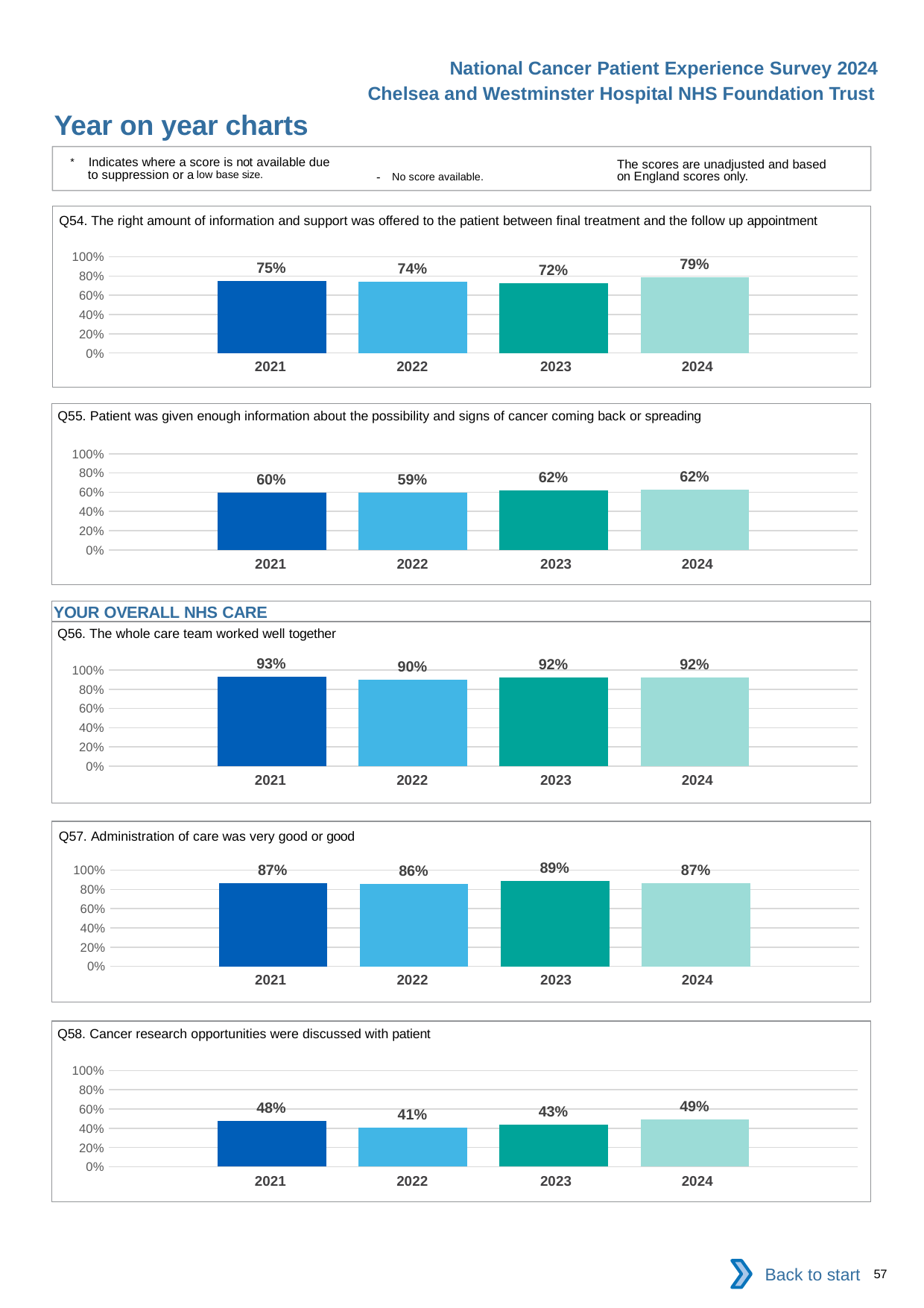
In the Q58 chart, which year has the highest value? 2024 In the Q54 chart, what is the value for 2024? 79% In the Q56 chart, what is the value for 2022? 90% In the Q57 chart, what is the difference between the 2023 value and the 2021 value? 2% How many years are shown on the x axis of the Q58 chart? 4 In the Q57 chart, which is larger, the value for 2023 or the value for 2022? 2023 In the Q56 chart, which year has the highest value? 2021 What kind of chart is the Q54 chart? Bar chart In the Q58 chart, what is the value for 2022? 41% In the Q54 chart, which year has the lowest value? 2023 In the Q55 chart, what is the difference between the 2023 value and the 2022 value? 3% In the Q55 chart, what is the value for 2022? 59%